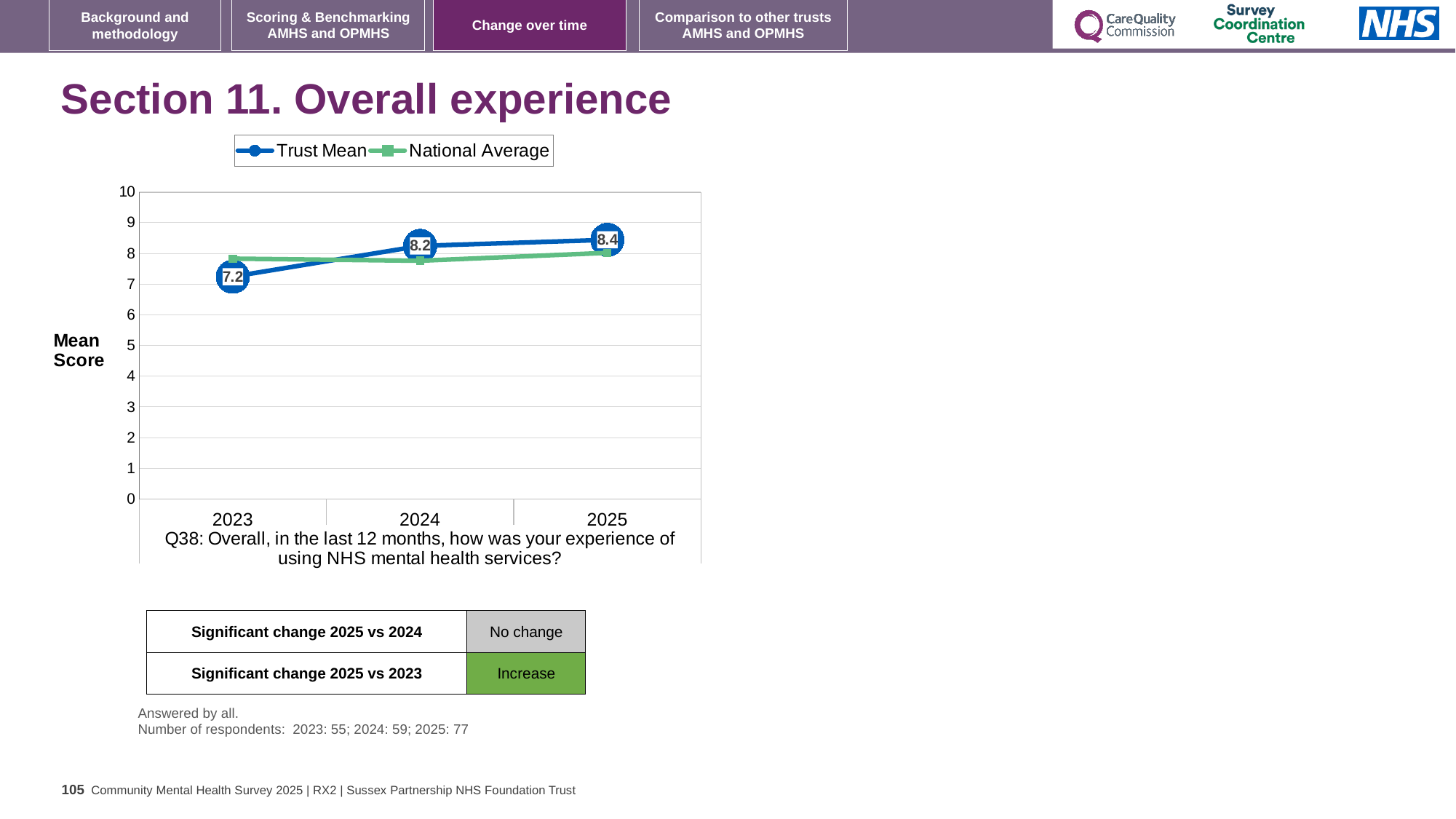
What is the Trust Mean value for 2025? 8.4 What is the difference between the Trust Mean in 2025 and in 2023? 1.2 What is the Trust Mean value for 2023? 7.2 Does the Trust Mean rise or fall from 2023 to 2025? rise In which year is the Trust Mean lowest? 2023 Which is larger, the Trust Mean in 2023 or the Trust Mean in 2025? 2025 In which year is the Trust Mean highest? 2025 How many years are plotted on the x axis? 3 What is the Trust Mean value for 2024? 8.2 Is the National Average value for 2023 greater or less than 7? greater How many series does the legend list? 2 What kind of chart is shown on the slide? line chart